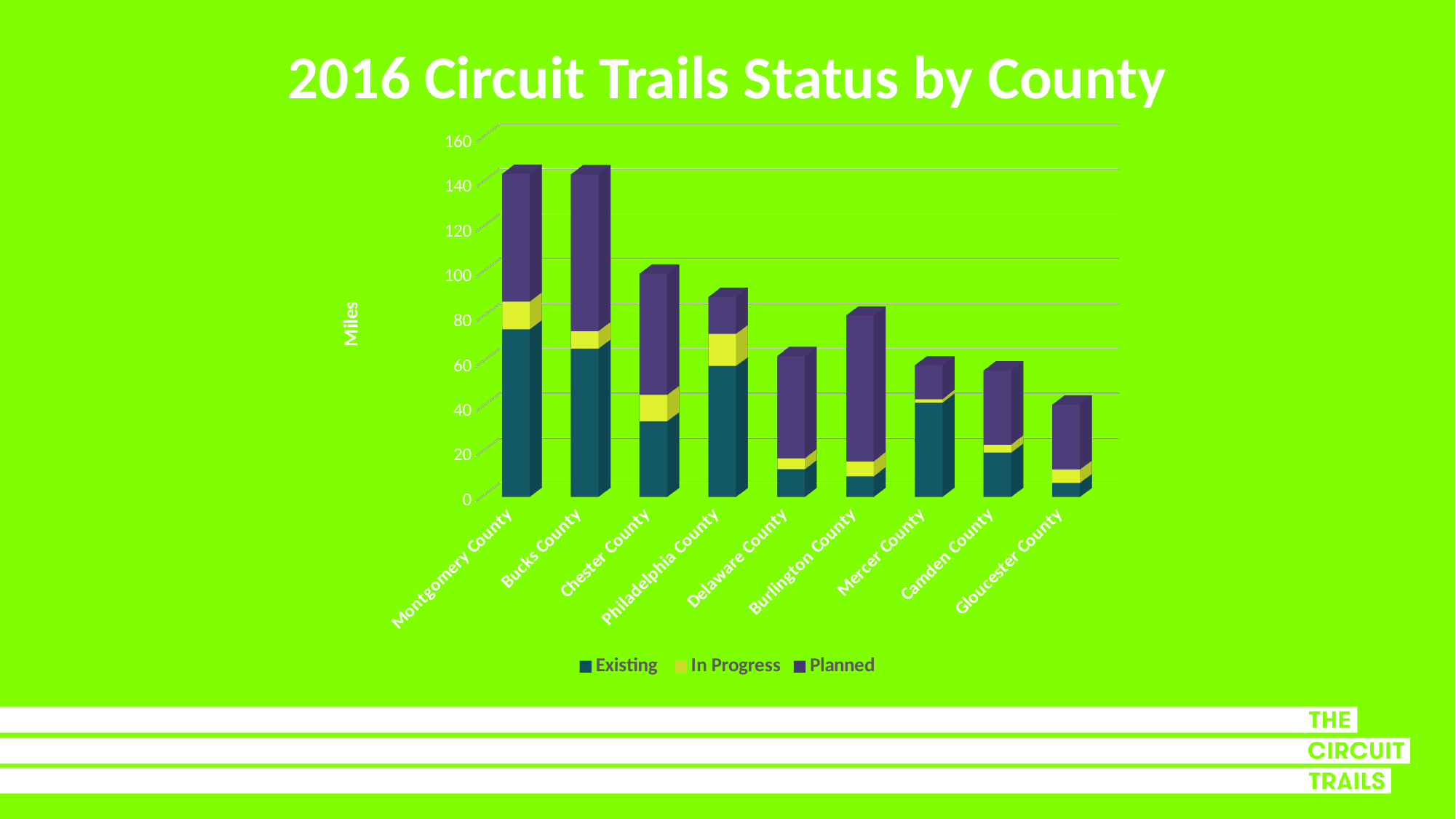
Which county has the largest Existing segment? Montgomery County Is the total bar for Burlington County greater or less than 60? greater Is the total bar for Montgomery County greater or less than 120? greater Is the total bar for Delaware County greater or less than 80? less Do the total bar heights generally rise or fall from left to right across the counties? Fall What kind of chart is shown on the slide? Stacked bar chart How many counties are shown on the x axis of the chart? 9 Which county has the lowest total bar in the chart? Gloucester County What is the title of the chart? 2016 Circuit Trails Status by County How many series does the chart's legend list? 3 Which has the taller total bar, Chester County or Philadelphia County? Chester County What is the label on the vertical axis of the chart? Miles